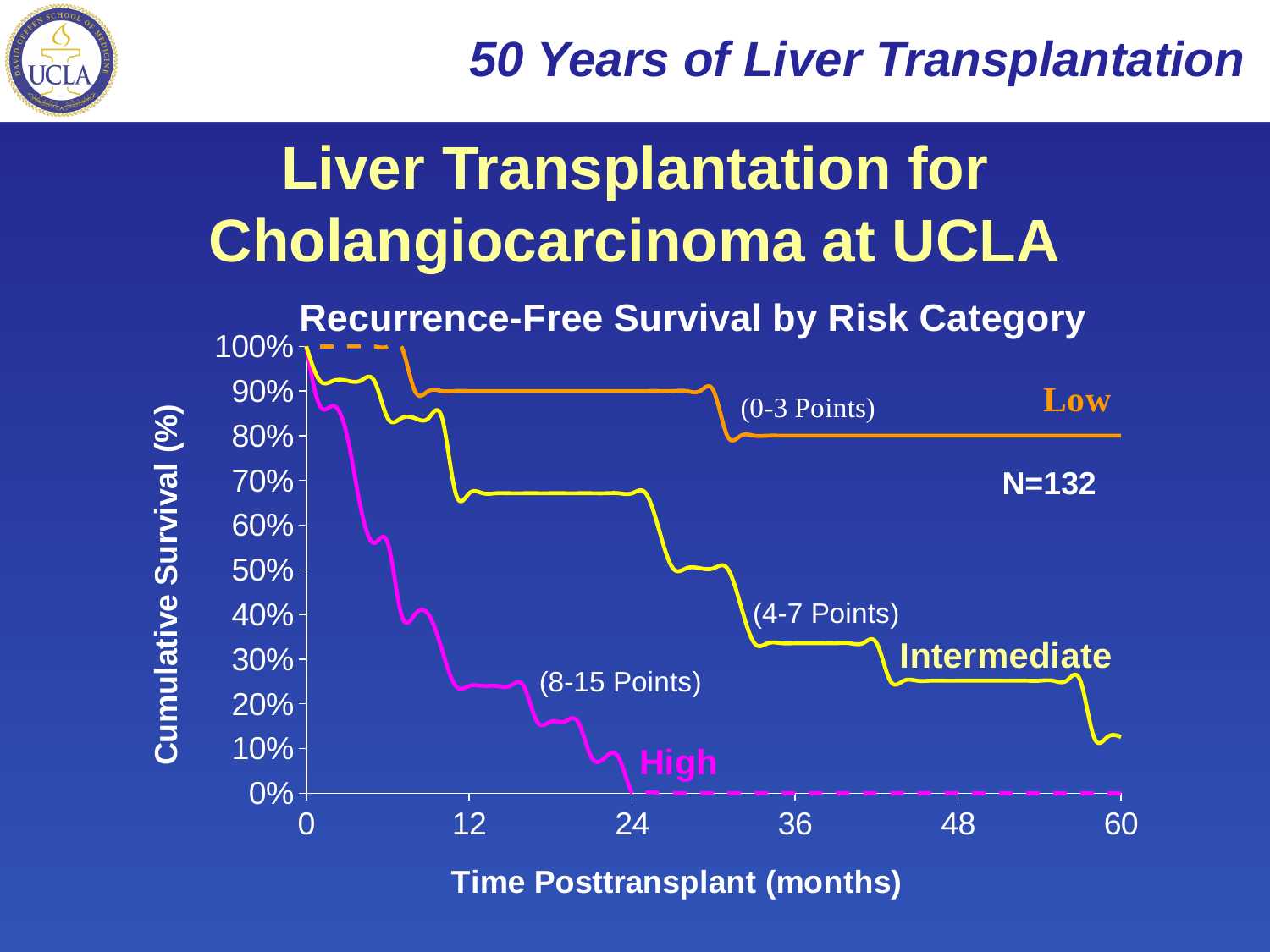
What is the title of the chart? Recurrence-Free Survival by Risk Category How many risk-category series are plotted on the chart? 3 Is the cumulative survival for the High group at 12 months greater or less than 30%? less Do the survival curves rise or fall as time posttransplant increases? Fall Which risk category has the lowest cumulative survival at 24 months? High At 12 months, which group has higher cumulative survival, Intermediate or High? Intermediate What kind of chart is shown on the slide? Line chart Is the cumulative survival for the Low group at 60 months greater or less than 50%? greater Is the cumulative survival for the Intermediate group at 60 months greater or less than 20%? less What is the label of the y axis? Cumulative Survival (%) At 36 months, which group has higher cumulative survival, Low or Intermediate? Low Which risk category has the highest cumulative survival at 60 months? Low